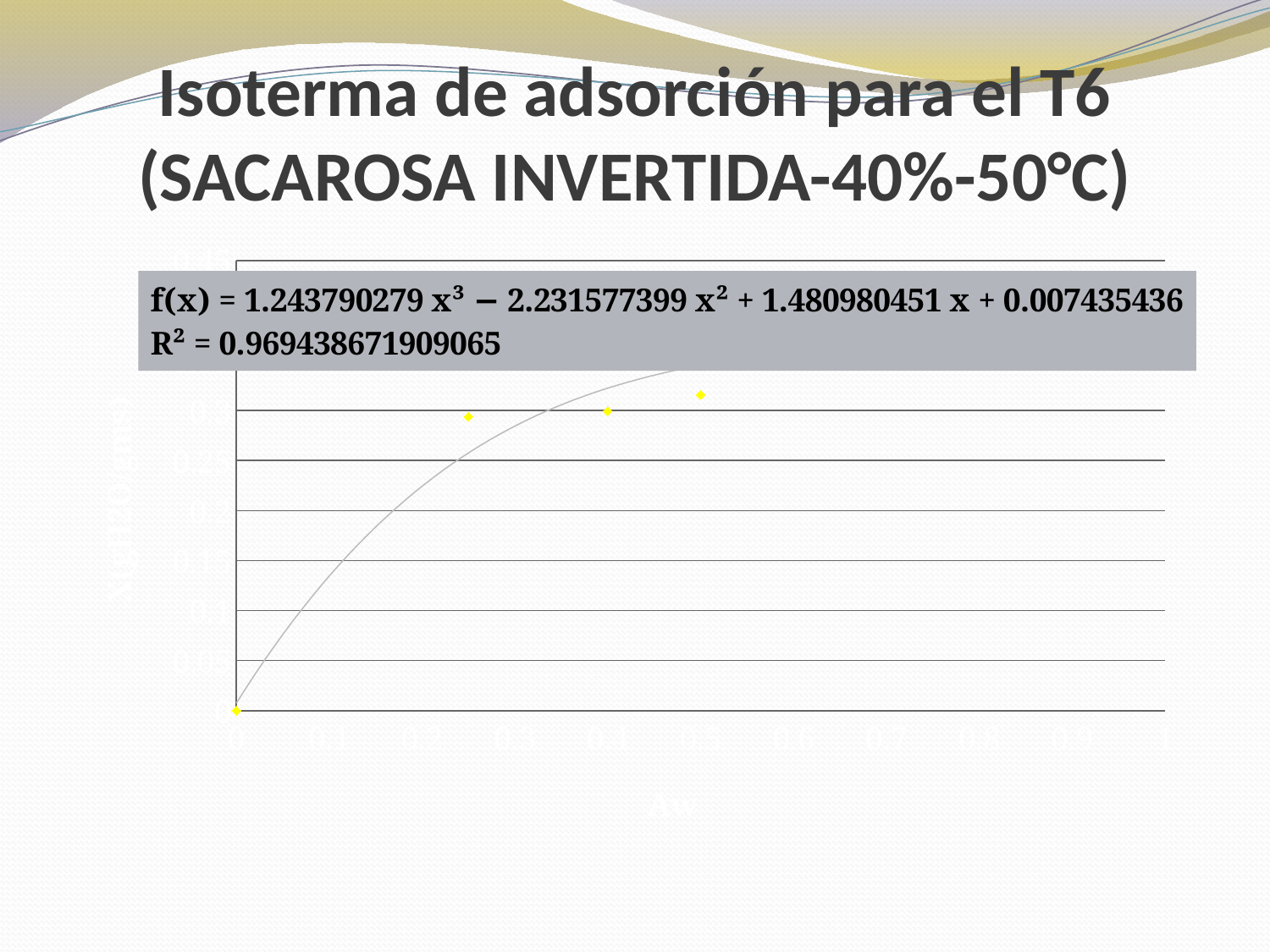
Do the plotted values generally rise or fall as the x axis increases from 0 to 0.5? rise What is the R² value shown for the trendline? 0.969438671909065 What is the constant term in the trendline equation shown on the chart? 0.007435436 What is the label of the x axis? Aw Is the value of the data point at x = 0 greater or less than 0.05? less Is the value of the data point at x = 0.5 greater or less than 0.25? greater What is the coefficient of x² in the trendline equation shown on the chart? −2.231577399 What is the highest value shown on the x axis? 1 What is the title of the chart on the slide? Isoterma de adsorción para el T6 (SACAROSA INVERTIDA-40%-50°C) What is the coefficient of x³ in the trendline equation shown on the chart? 1.243790279 What kind of chart is shown on the slide? scatter chart